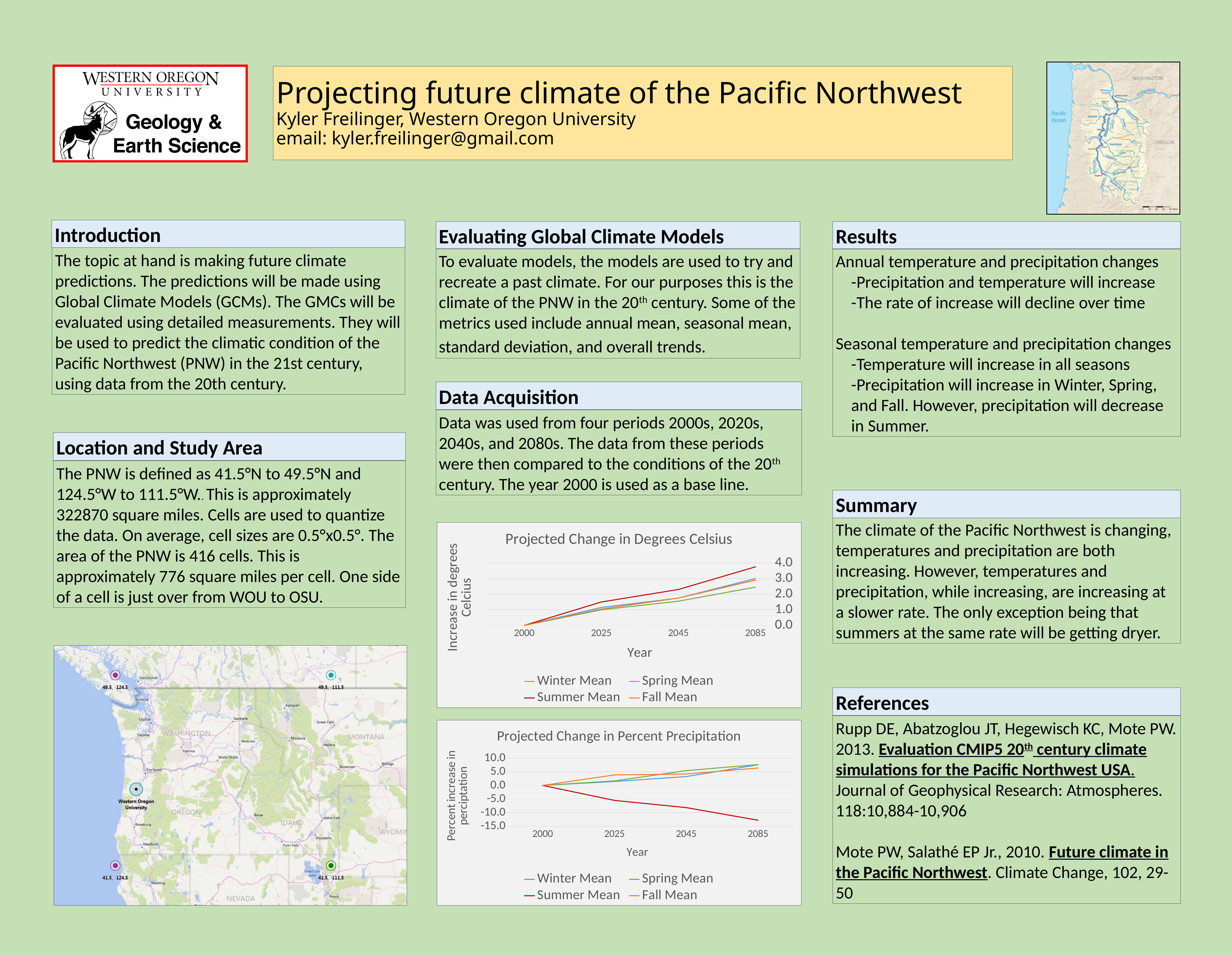
In "Projected Change in Degrees Celsius", which series has the highest value at 2085? Summer Mean How many series does the legend of "Projected Change in Degrees Celsius" list? 4 In "Projected Change in Degrees Celsius", is the Summer Mean value at 2085 greater or less than 3.0? greater What kind of chart is "Projected Change in Percent Precipitation"? line chart In "Projected Change in Percent Precipitation", which series has the lowest value at 2085? Summer Mean In "Projected Change in Degrees Celsius", which series has the lowest value at 2085? Spring Mean What is the y-axis label of "Projected Change in Percent Precipitation"? Percent increase in percipitation In "Projected Change in Percent Precipitation", is the Summer Mean value at 2085 greater or less than -10.0? less In "Projected Change in Percent Precipitation", does the Summer Mean series rise or fall from 2000 to 2085? fall In "Projected Change in Degrees Celsius", do the values rise or fall from 2000 to 2085? rise What kind of chart is "Projected Change in Degrees Celsius"? line chart In "Projected Change in Degrees Celsius", how many years are marked on the x axis? 4